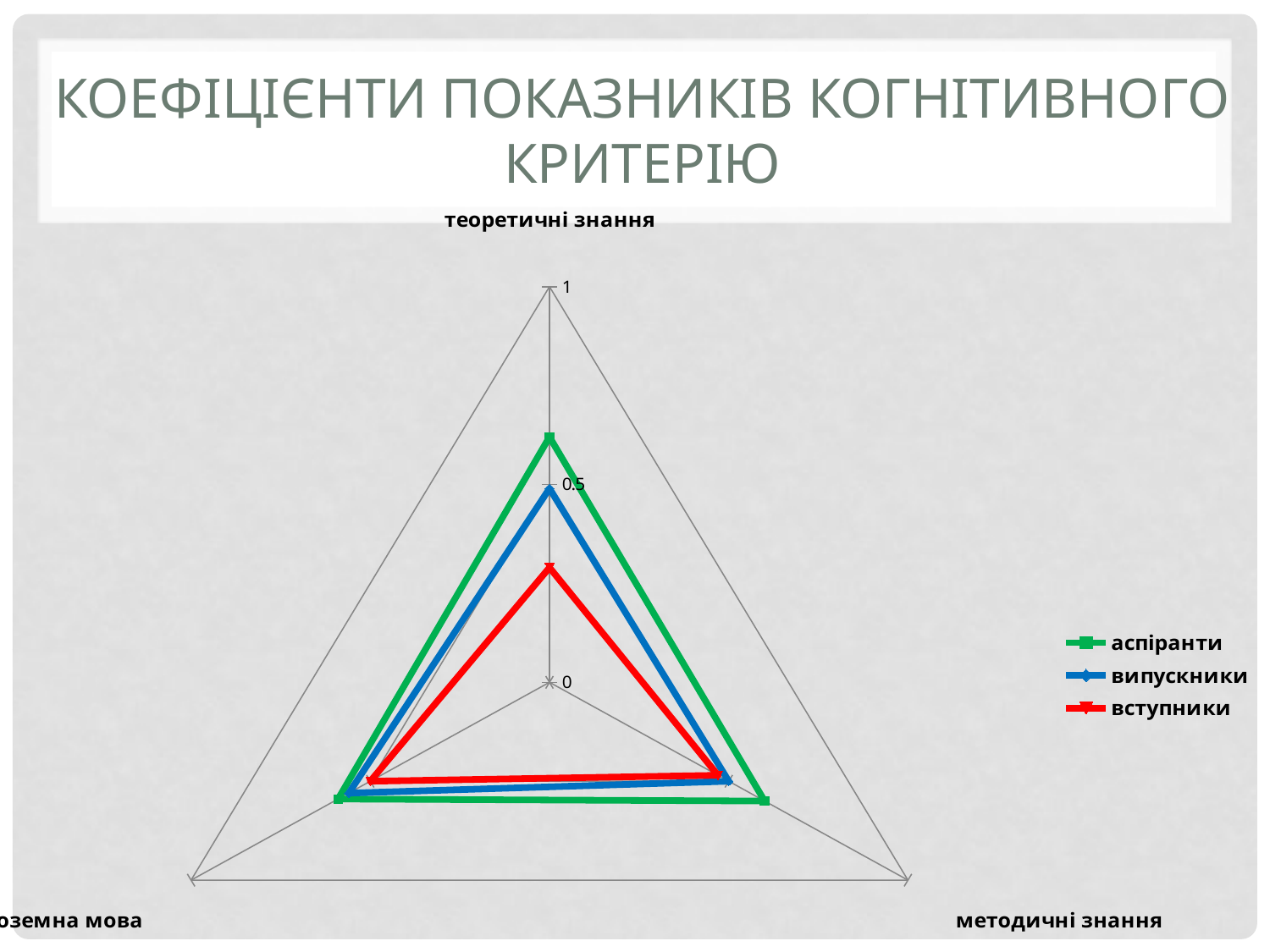
What is the title of the slide? Коефіцієнти показників когнітивного критерію What kind of chart is shown on the slide? radar chart How many series does the legend list? 3 Is the value for вступники on the теоретичні знання axis greater or less than 0.5? less Is the value for аспіранти on the методичні знання axis greater or less than 0.5? greater On the методичні знання axis, which is larger: аспіранти or вступники? аспіранти Which series has the lowest value on the теоретичні знання axis? вступники How many axes (categories) does the radar chart have? 3 What colour is the line for аспіранти? green Is the value for аспіранти on the теоретичні знання axis greater or less than 0.5? greater Which series has the highest value on the теоретичні знання axis? аспіранти